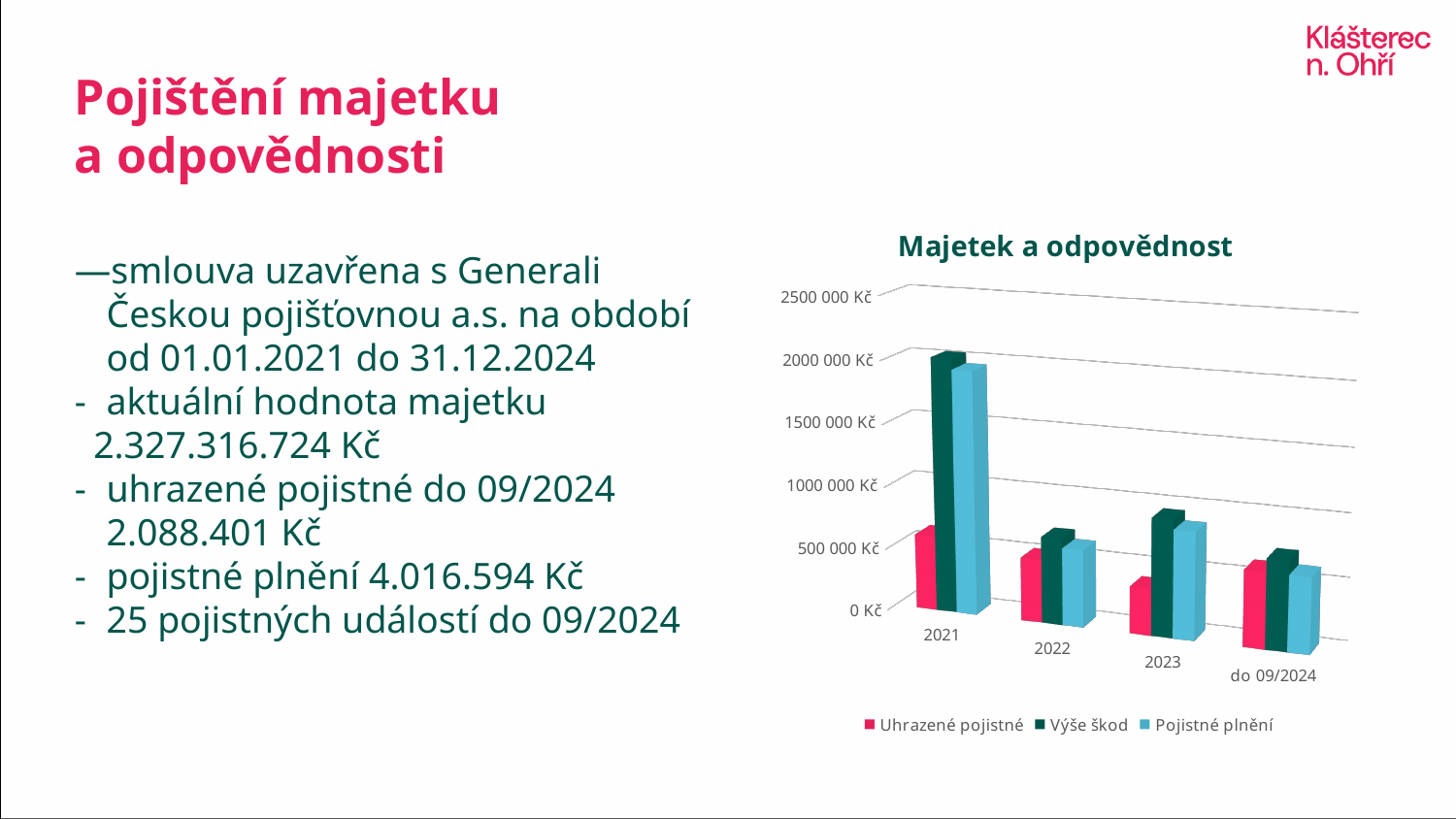
What is the title of the chart? Majetek a odpovědnost Is the value for Výše škod in 2022 greater or less than 1000 000 Kč? less In 2021, which is larger: Uhrazené pojistné or Výše škod? Výše škod How many series does the chart legend list? 3 Does the value for Výše škod rise or fall from 2021 to 2022? fall What type of chart is shown on the slide? bar chart How many categories are shown on the x axis of the chart? 4 Is the value for Výše škod in 2021 greater or less than 1500 000 Kč? greater Is the value for Pojistné plnění in 2021 greater or less than 1500 000 Kč? greater Which series is shown in dark green in the chart? Výše škod In which year is the value for Výše škod the highest? 2021